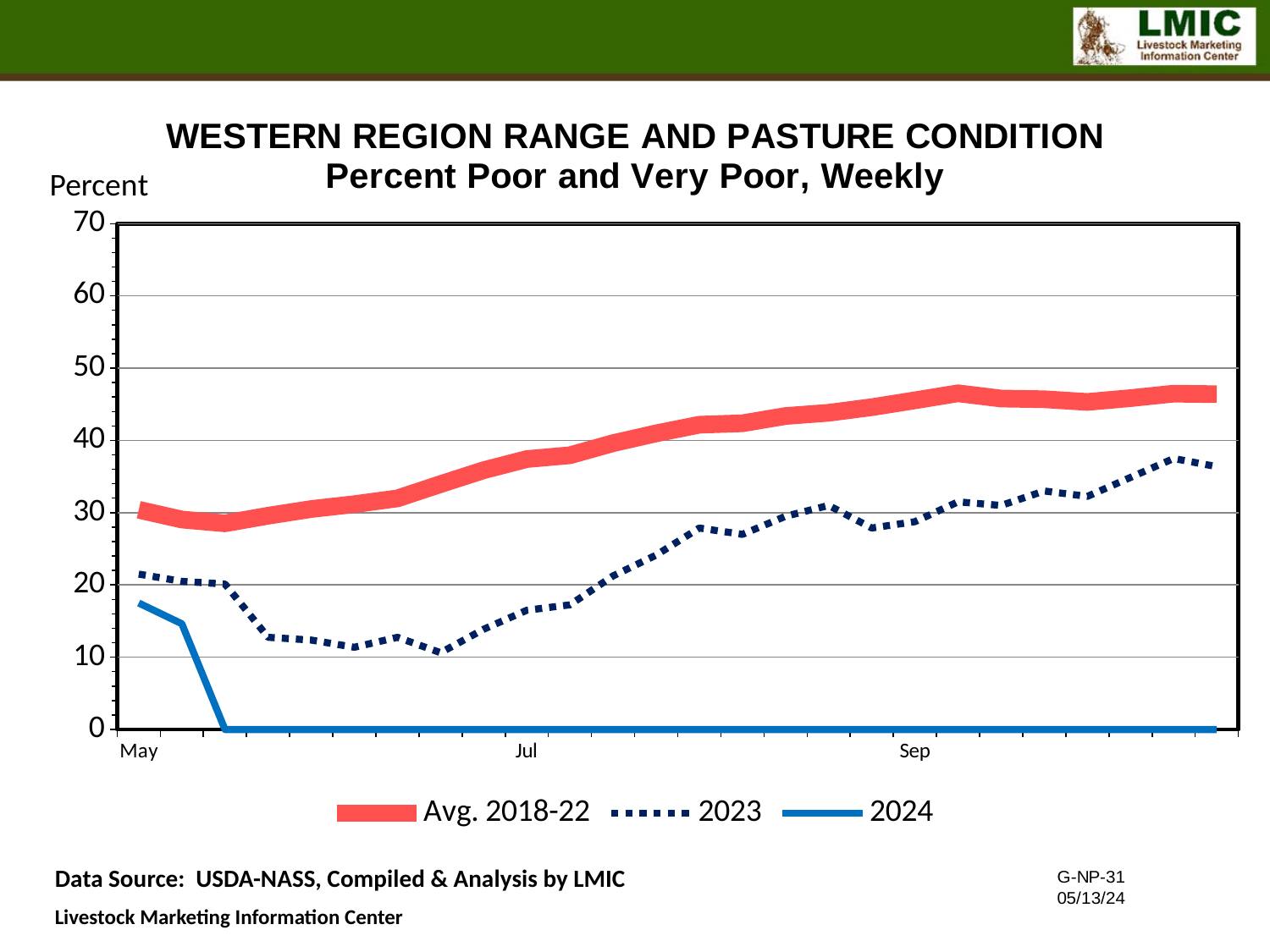
Does the 2024 series rise or fall over the weeks it is plotted? fall Which series has the highest values across the chart? Avg. 2018-22 Is the value for 2023 at Jul greater or less than 20? less At Jul, which series has the larger value, Avg. 2018-22 or 2023? Avg. 2018-22 What kind of chart is shown on the slide? line chart What label is shown on the vertical axis? Percent Does the Avg. 2018-22 series rise or fall from May to Sep? rise What is the title of the chart? WESTERN REGION RANGE AND PASTURE CONDITION Percent Poor and Very Poor, Weekly How many series does the legend list? 3 Is the value for 2024 at May greater or less than 20? less Is the value for Avg. 2018-22 at Sep greater or less than 40? greater